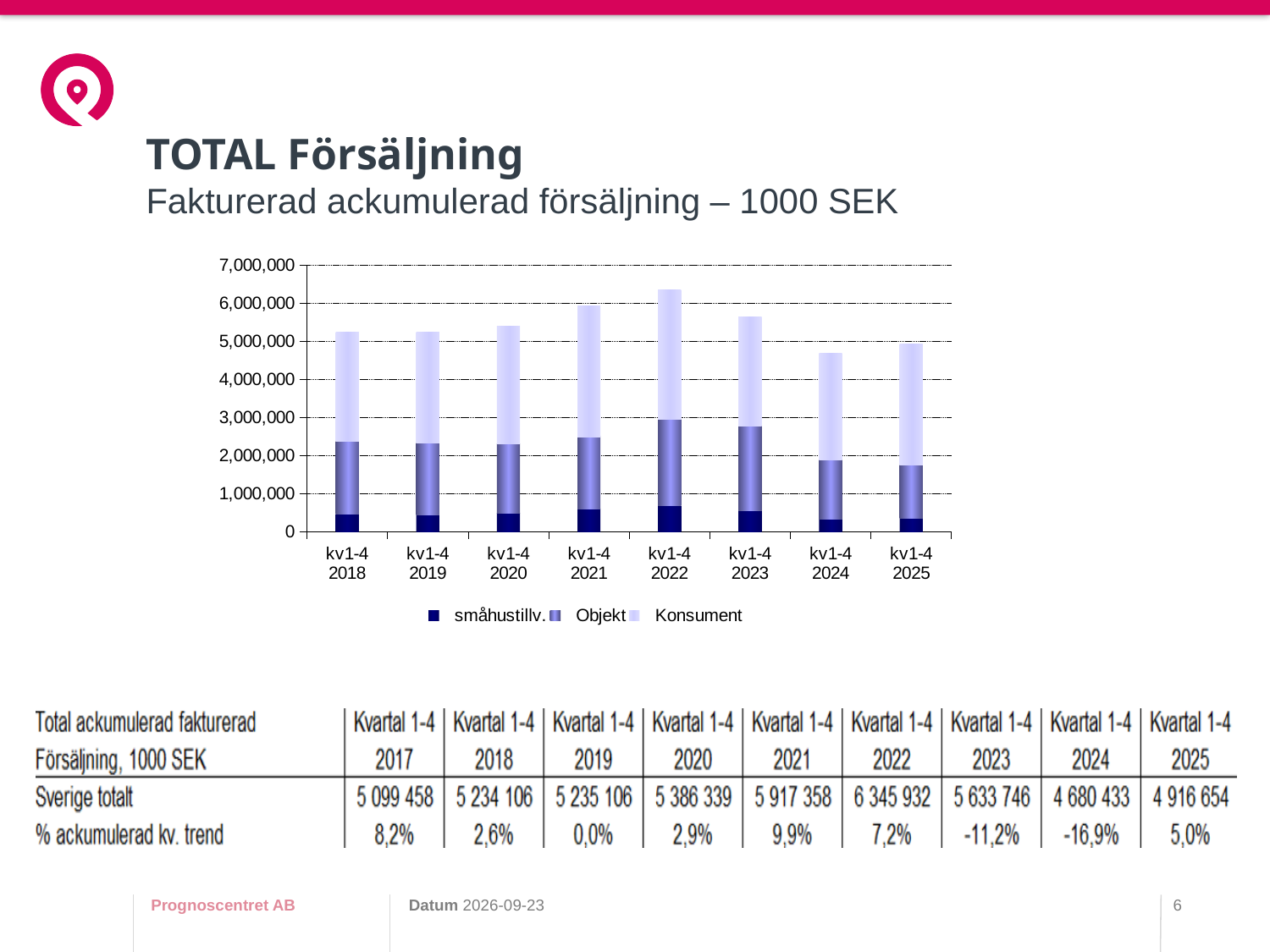
Which stacked bar is taller, kv1-4 2021 or kv1-4 2023? kv1-4 2021 According to the table on the slide, what is the total (Sverige totalt) for Kvartal 1-4 2022? 6 345 932 Which period has the tallest stacked bar in the chart? kv1-4 2022 Is the total bar for kv1-4 2024 greater or less than 5,000,000? less What kind of chart is shown on the slide? bar chart How many periods (bars) are shown on the x axis of the chart? 8 Which series is shown in the lightest colour at the top of each stacked bar? Konsument Is the total bar for kv1-4 2022 greater or less than 6,000,000? greater How many series does the chart legend list? 3 Which period has the shortest stacked bar in the chart? kv1-4 2024 Do the stacked bar totals rise or fall from kv1-4 2022 to kv1-4 2024? fall Is the total bar for kv1-4 2021 greater or less than 6,000,000? less